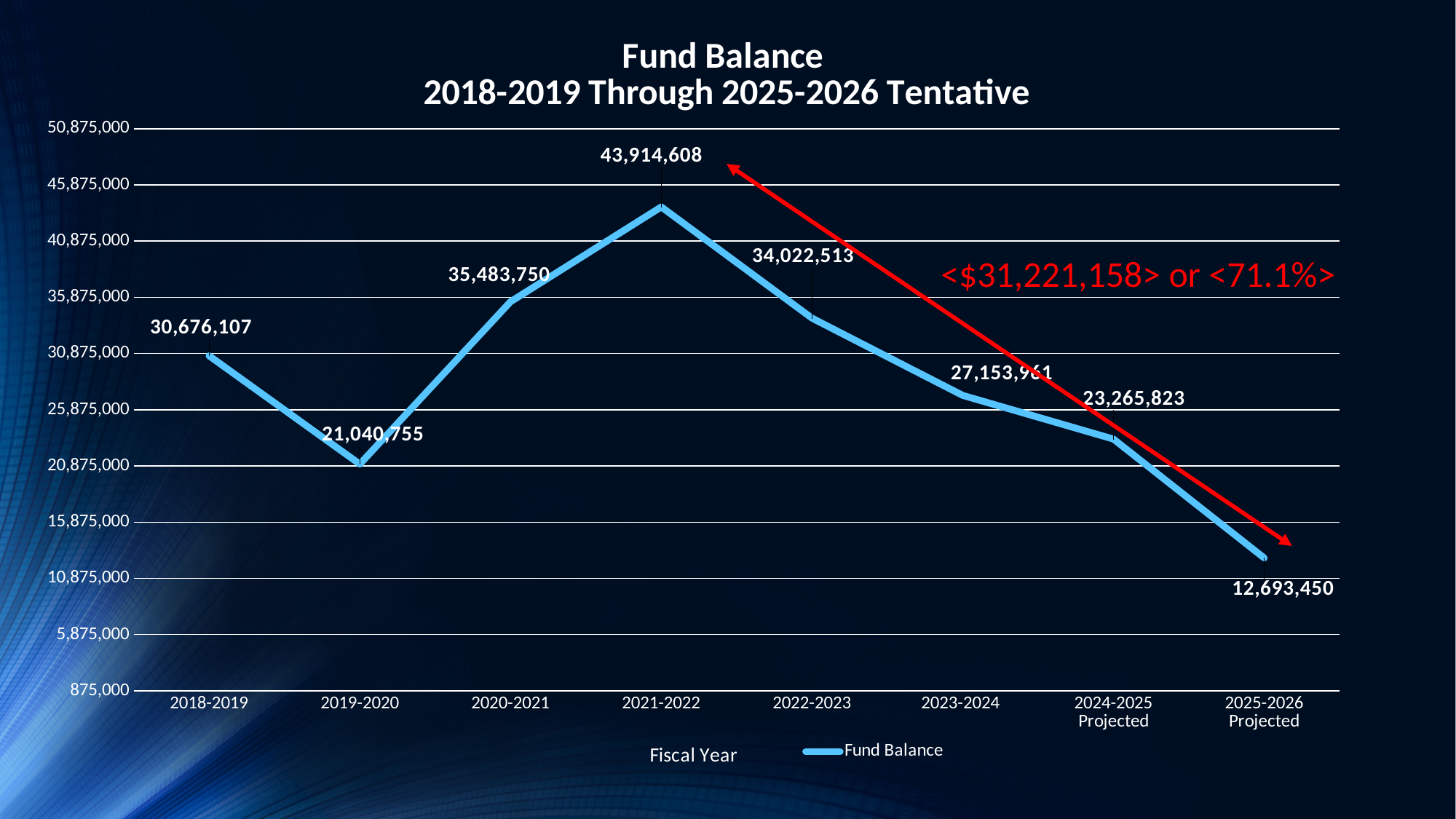
What is the fund balance for 2019-2020? 21,040,755 Which fiscal year has the highest fund balance? 2021-2022 How many fiscal years are plotted on the chart? 8 Is the fund balance for 2023-2024 greater or less than 25,875,000? greater What is the projected fund balance for 2025-2026? 12,693,450 What is the fund balance for 2021-2022? 43,914,608 Which fiscal year has the lowest fund balance? 2025-2026 Projected What is the difference between the fund balance in 2021-2022 and the projected fund balance in 2025-2026? 31,221,158 What kind of chart is shown on the slide? line chart Does the fund balance rise or fall from 2021-2022 through 2025-2026? fall Which is larger, the fund balance for 2020-2021 or for 2022-2023? 2020-2021 What is the difference between the fund balance in 2018-2019 and in 2019-2020? 9,635,352